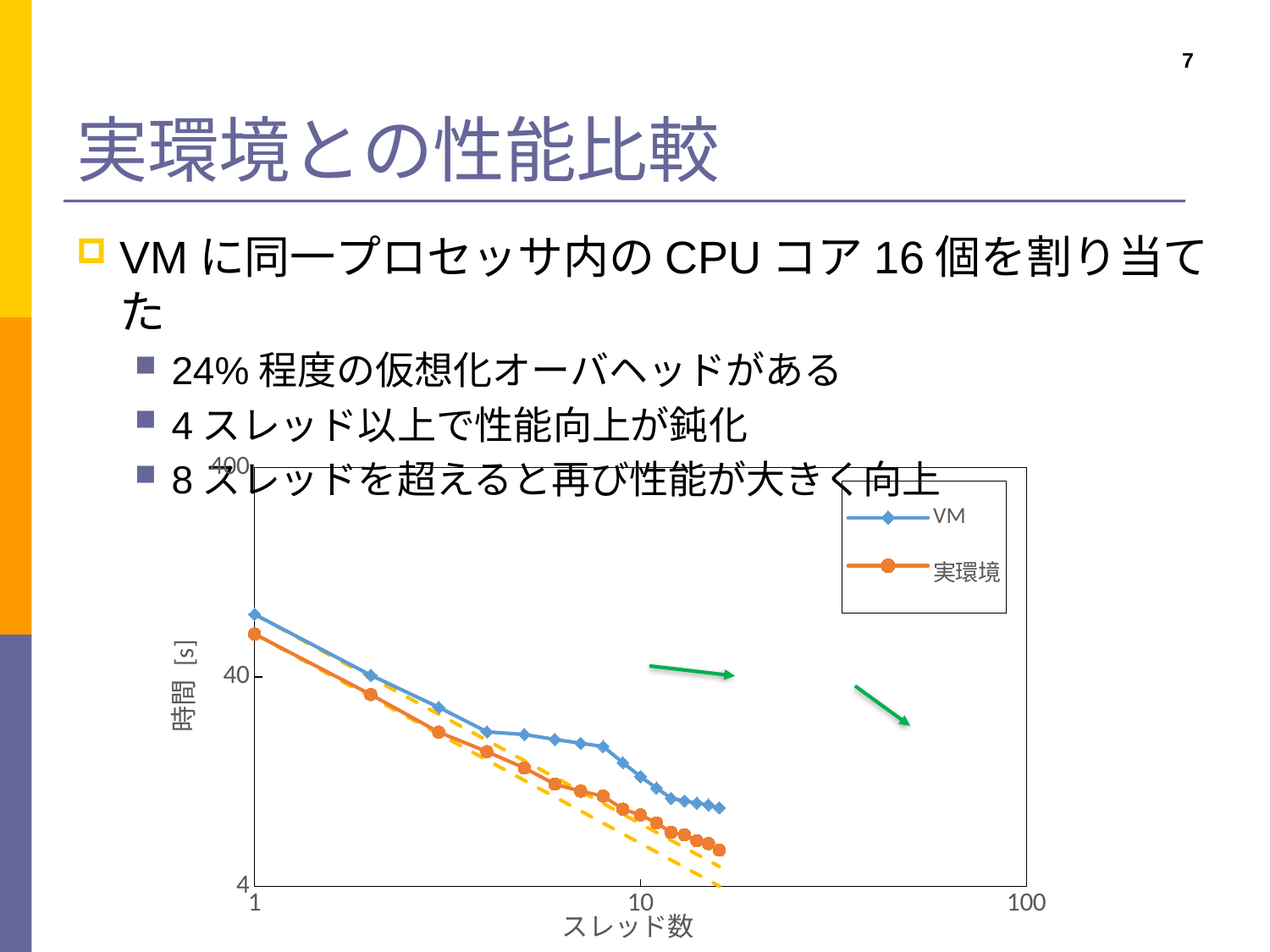
What is the label of the x axis of the chart? スレッド数 Is the value for 実環境 at 16 threads greater or less than 40? less Is the value for VM at 16 threads greater or less than 4? greater What are the two series named in the chart legend? VM and 実環境 Which series has the higher time at 1 thread, VM or 実環境? VM Which series has the higher time at 16 threads, VM or 実環境? VM Do the values of the 実環境 series rise or fall as the number of threads increases? fall How many series does the chart legend list? 2 How many data points does the VM series have? 16 Is the value for VM at 1 thread greater or less than 40? greater What kind of chart is shown on the slide? line chart Do the values of the VM series rise or fall as the number of threads increases? fall